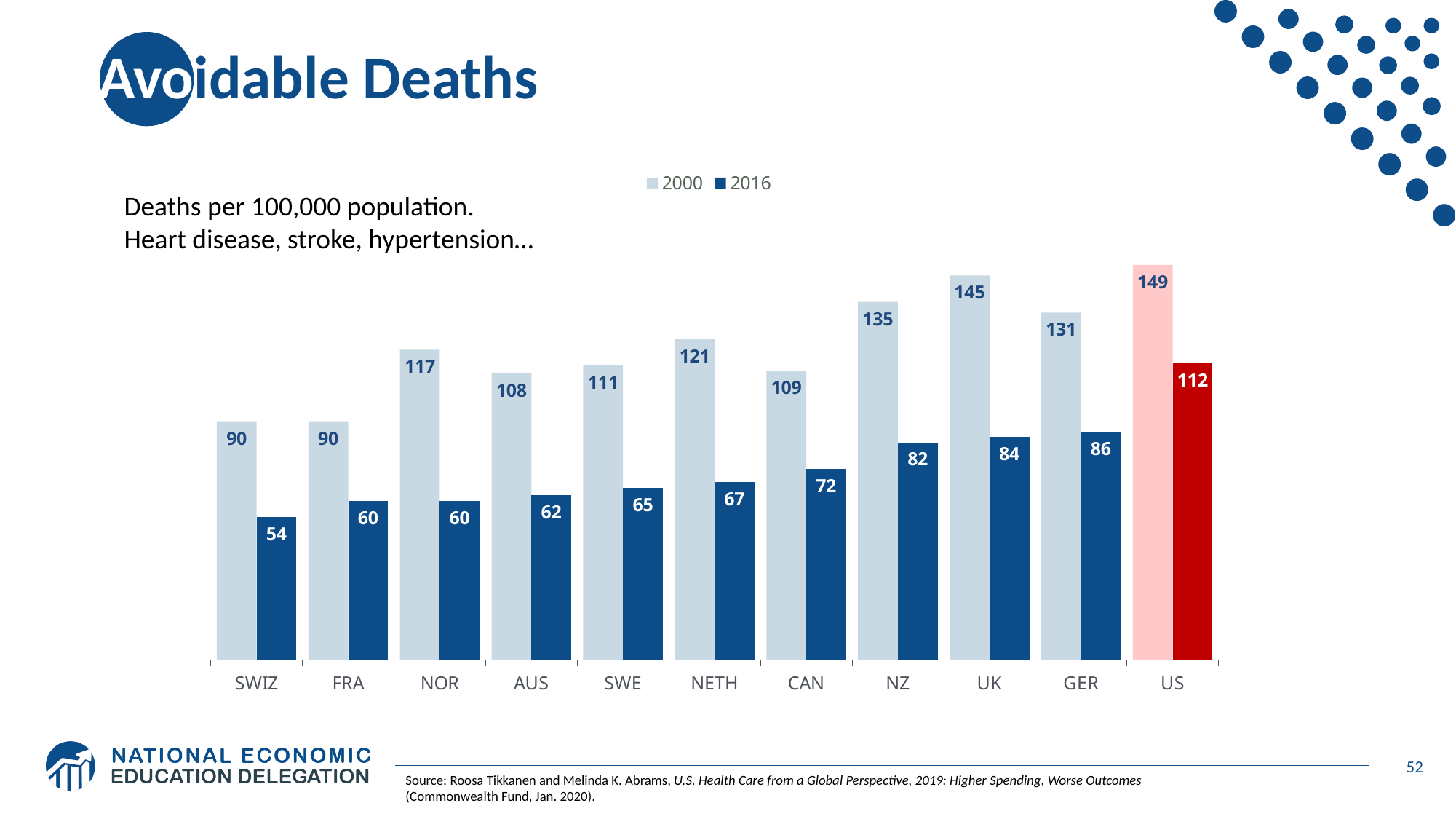
What is the difference between the US values for 2000 and 2016? 37 What is the difference between the 2000 and 2016 values for Norway (NOR)? 57 How many series does the legend list? 2 Which country had the highest value in 2000? US What kind of chart is shown on the slide? Bar chart Which is larger: the 2016 value for Germany (GER) or the 2016 value for New Zealand (NZ)? GER Which country had the lowest value in 2016? SWIZ What was the value for Switzerland (SWIZ) in 2000? 90 Which two series are listed in the legend? 2000 and 2016 What was the value for the UK in 2016? 84 How many countries are shown on the x axis? 11 What was the value for the US in 2016? 112